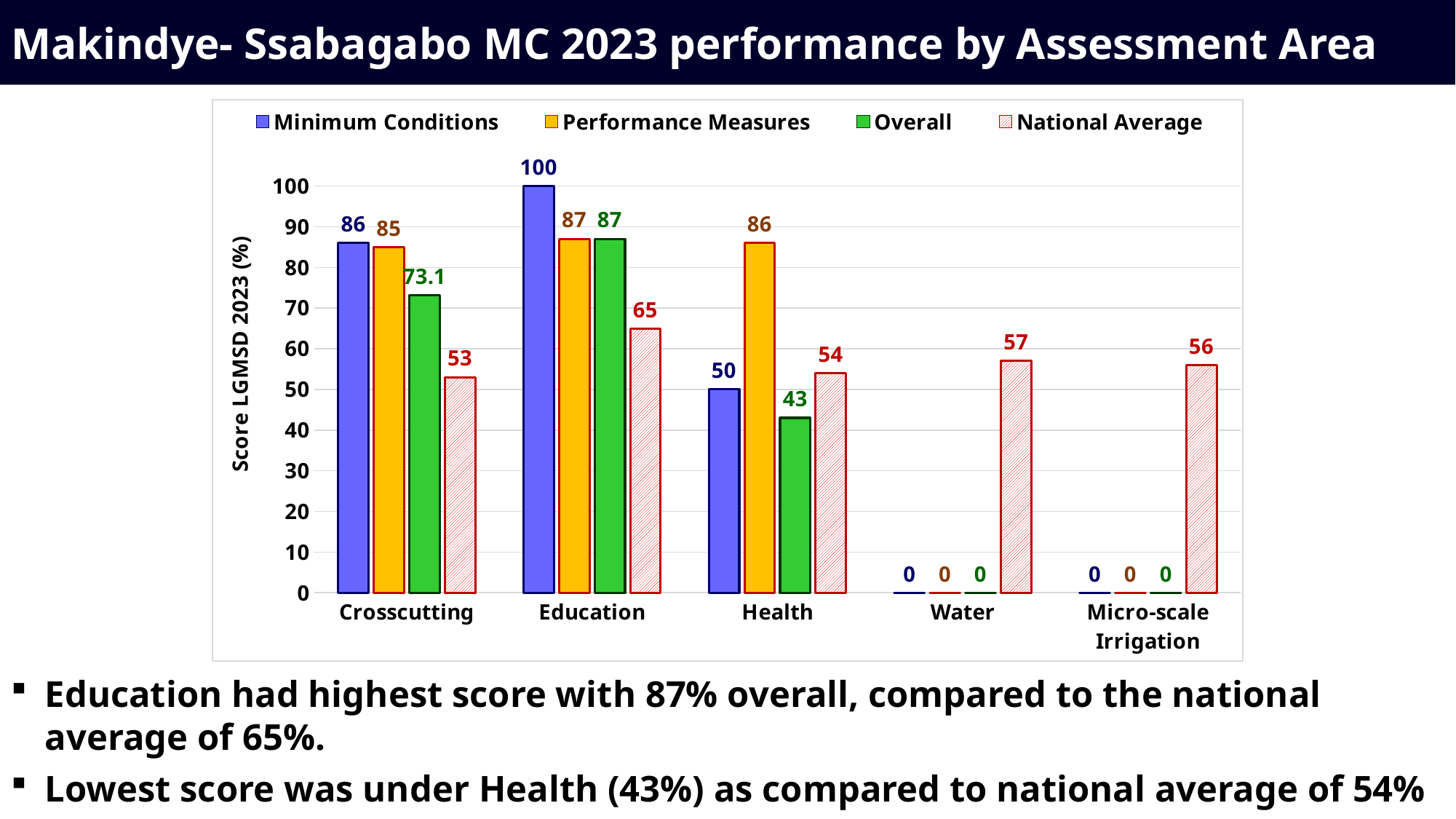
Which is larger for Crosscutting: the Minimum Conditions score or the Performance Measures score? Minimum Conditions What is the label of the vertical axis? Score LGMSD 2023 (%) What is the Performance Measures score for Health? 86 What is the Minimum Conditions score for Education? 100 What kind of chart is shown on the slide? Bar chart What is the Overall score for Crosscutting? 73.1 Which assessment area has the lowest National Average value? Crosscutting How many series does the legend list? 4 What is the difference between the Overall score and the National Average for Health? 11 What is the National Average value for Water? 57 Which assessment area has the highest Overall score? Education How many assessment areas are shown on the x axis? 5